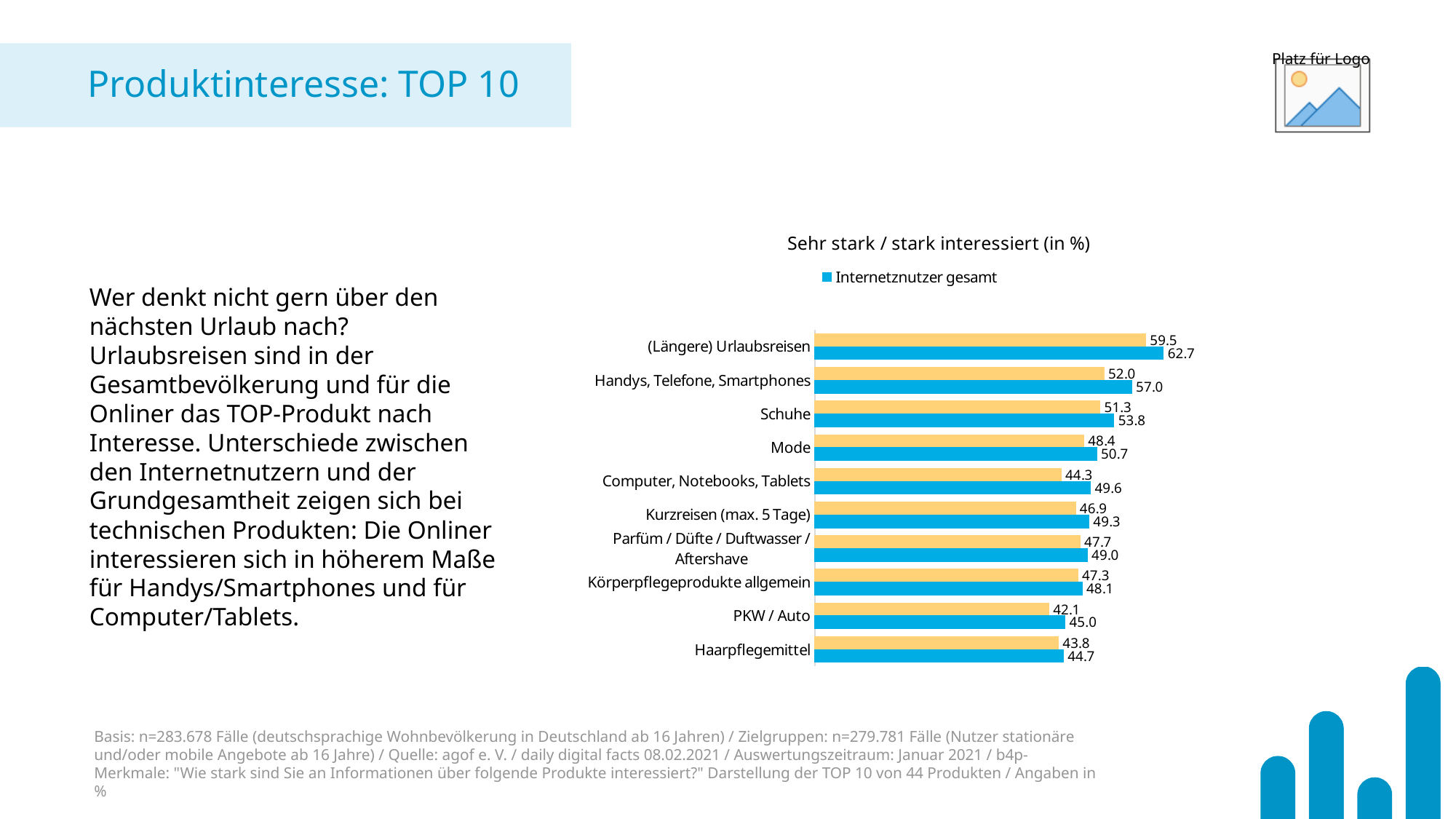
What is the chart's title? Sehr stark / stark interessiert (in %) Which category has the highest value for Internetznutzer gesamt? (Längere) Urlaubsreisen What is the value shown on the yellow bar for Haarpflegemittel? 43.8 What is the value for Internetznutzer gesamt for PKW / Auto? 45.0 What is the difference between the Internetznutzer gesamt values for Handys, Telefone, Smartphones and Mode? 6.3 What is the value for Internetznutzer gesamt for (Längere) Urlaubsreisen? 62.7 How many product categories are shown in the chart? 10 Which has the larger Internetznutzer gesamt value, Computer, Notebooks, Tablets or Kurzreisen (max. 5 Tage)? Computer, Notebooks, Tablets Which category has the lowest value for Internetznutzer gesamt? Haarpflegemittel What is the value for Internetznutzer gesamt for Schuhe? 53.8 What kind of chart is shown on the slide? bar chart How many series does the legend list? 1